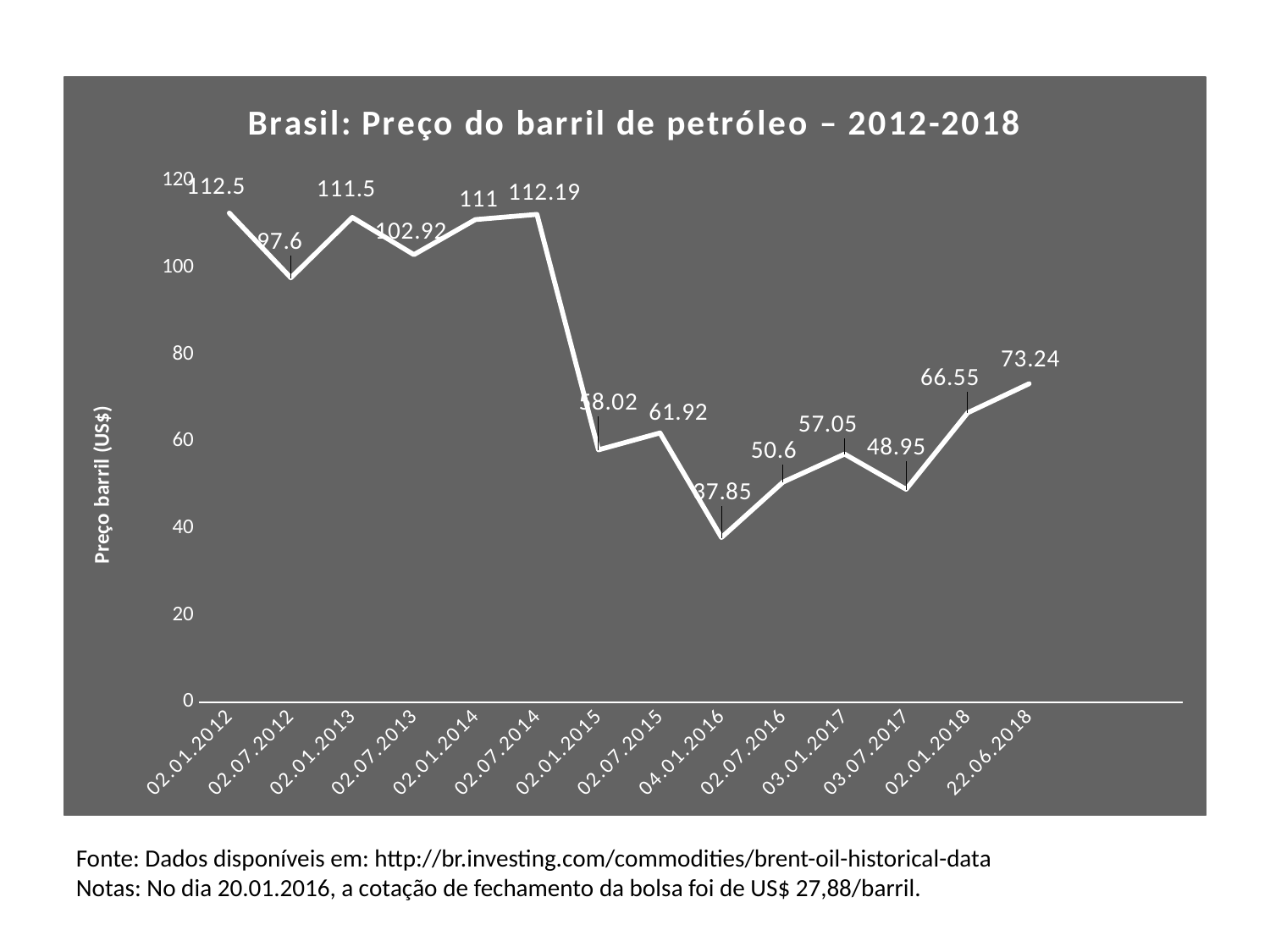
What is the oil barrel price shown for 02.01.2012? 112.5 On which date is the lowest oil barrel price recorded? 04.01.2016 What is the oil barrel price shown for 02.07.2013? 102.92 What type of chart is shown on the slide? Line chart How many data points are plotted on the line? 14 Which date has a higher price: 02.07.2016 or 03.01.2017? 03.01.2017 What is the label of the vertical axis? Preço barril (US$) What is the oil barrel price shown for 04.01.2016? 37.85 What is the difference between the price on 02.07.2014 and the price on 02.01.2015? 54.17 Does the price rise or fall between 03.07.2017 and 22.06.2018? Rise What is the oil barrel price shown for 22.06.2018? 73.24 On which date is the highest oil barrel price recorded? 02.01.2012